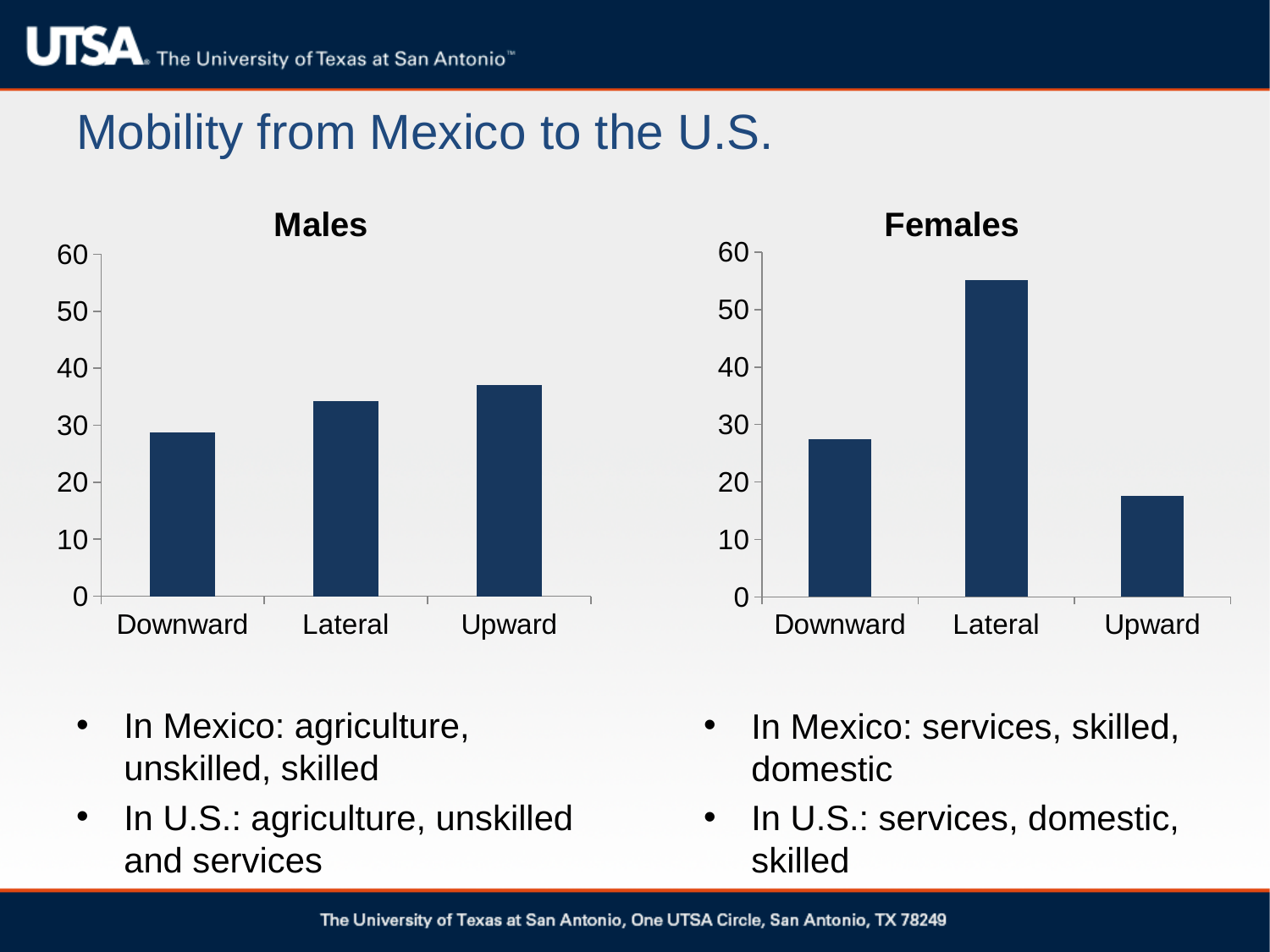
How many categories are shown on the Females chart? 3 In the Males chart, which category has the lowest value? Downward In the Females chart, is the value for Lateral greater or less than 50? greater In the Males chart, is the value for Lateral greater or less than 30? greater In the Females chart, which category has the highest value? Lateral In the Males chart, do the values rise or fall from Downward to Upward along the x axis? rise In the Males chart, is the value for Upward greater or less than 40? less In the Males chart, which category has the highest value? Upward In the Females chart, which category has the lowest value? Upward What kind of chart is the Males chart? bar chart In the Females chart, which is larger, the value for Downward or the value for Upward? Downward